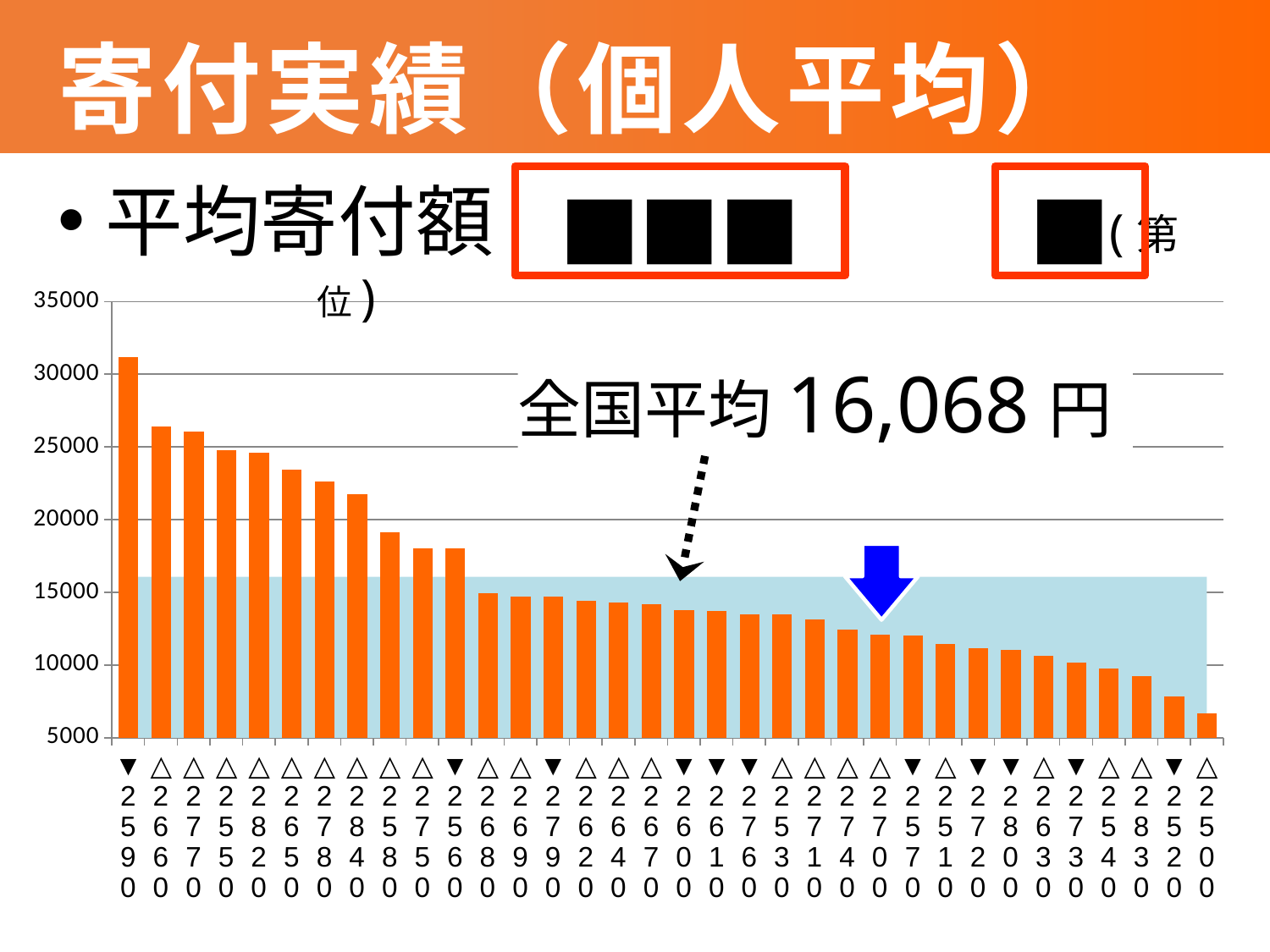
What national average value (全国平均) is printed on the chart? 16,068 円 Is the value for △2660 greater or less than 25000? greater What colour are the bars in the chart? orange Is the value for △2500 greater or less than 10000? less Is the value for ▼2590 greater or less than 30000? greater Which is larger, the value for ▼2590 or the value for △2500? ▼2590 Which category has the lowest bar? △2500 Do the bar values rise or fall from left to right along the x axis? fall Which category has the highest bar? ▼2590 What kind of chart is shown on the slide? bar chart How many bars are plotted in the chart? 34